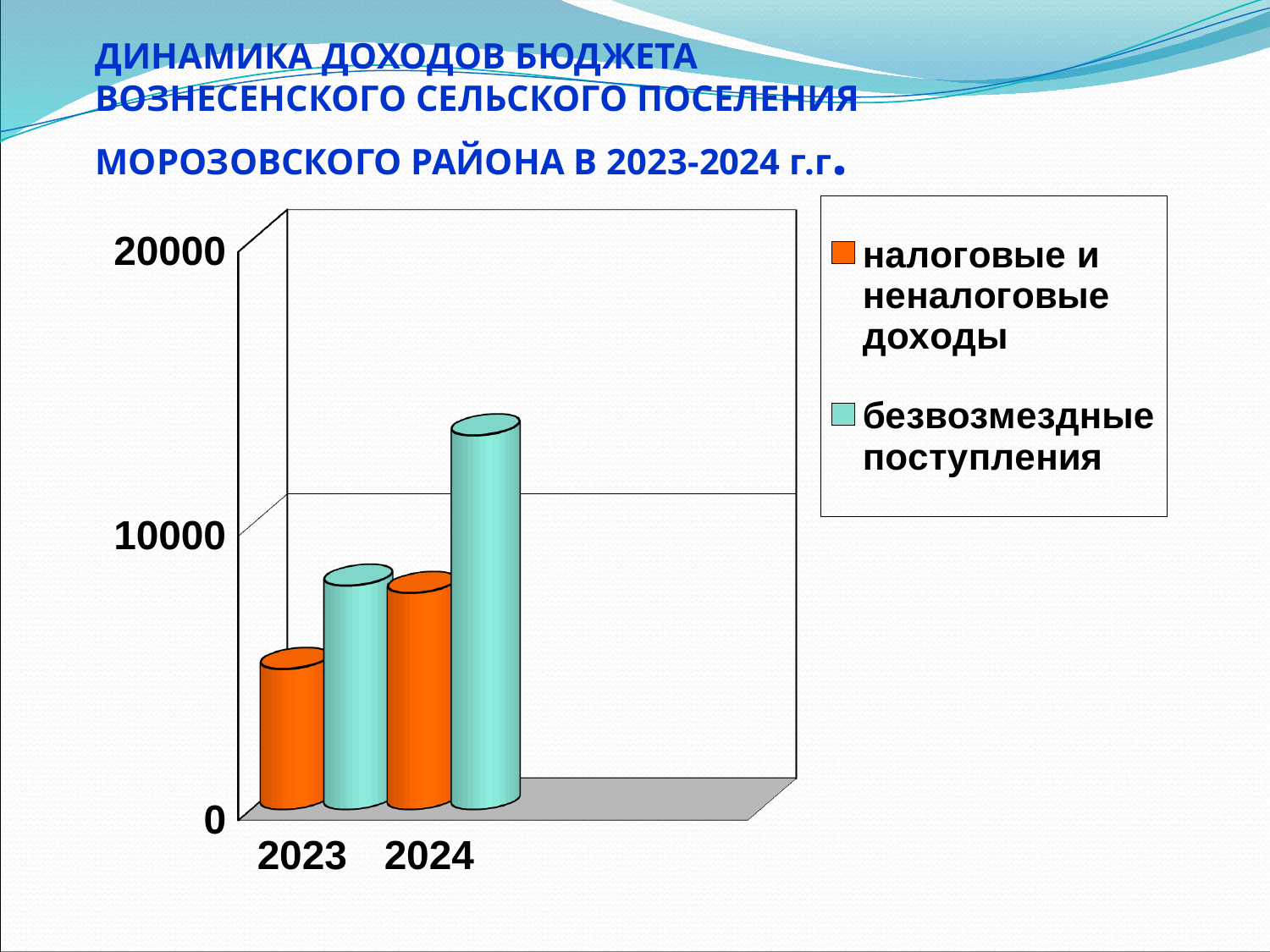
Is the value for налоговые и неналоговые доходы in 2023 greater or less than 10000? less Which is larger: налоговые и неналоговые доходы in 2023 or in 2024? 2024 Which is larger in 2023: налоговые и неналоговые доходы or безвозмездные поступления? безвозмездные поступления Do the values for безвозмездные поступления rise or fall from 2023 to 2024? rise Is the value for безвозмездные поступления in 2023 greater or less than 10000? less Which bar is the tallest in the chart? безвозмездные поступления in 2024 Which is larger: безвозмездные поступления in 2023 or безвозмездные поступления in 2024? 2024 Is the value for безвозмездные поступления in 2024 greater or less than 10000? greater Which colour represents налоговые и неналоговые доходы in the legend? orange How many years (categories) are shown on the x axis of the chart? 2 How many series does the chart's legend list? 2 What kind of chart is shown on the slide? bar chart